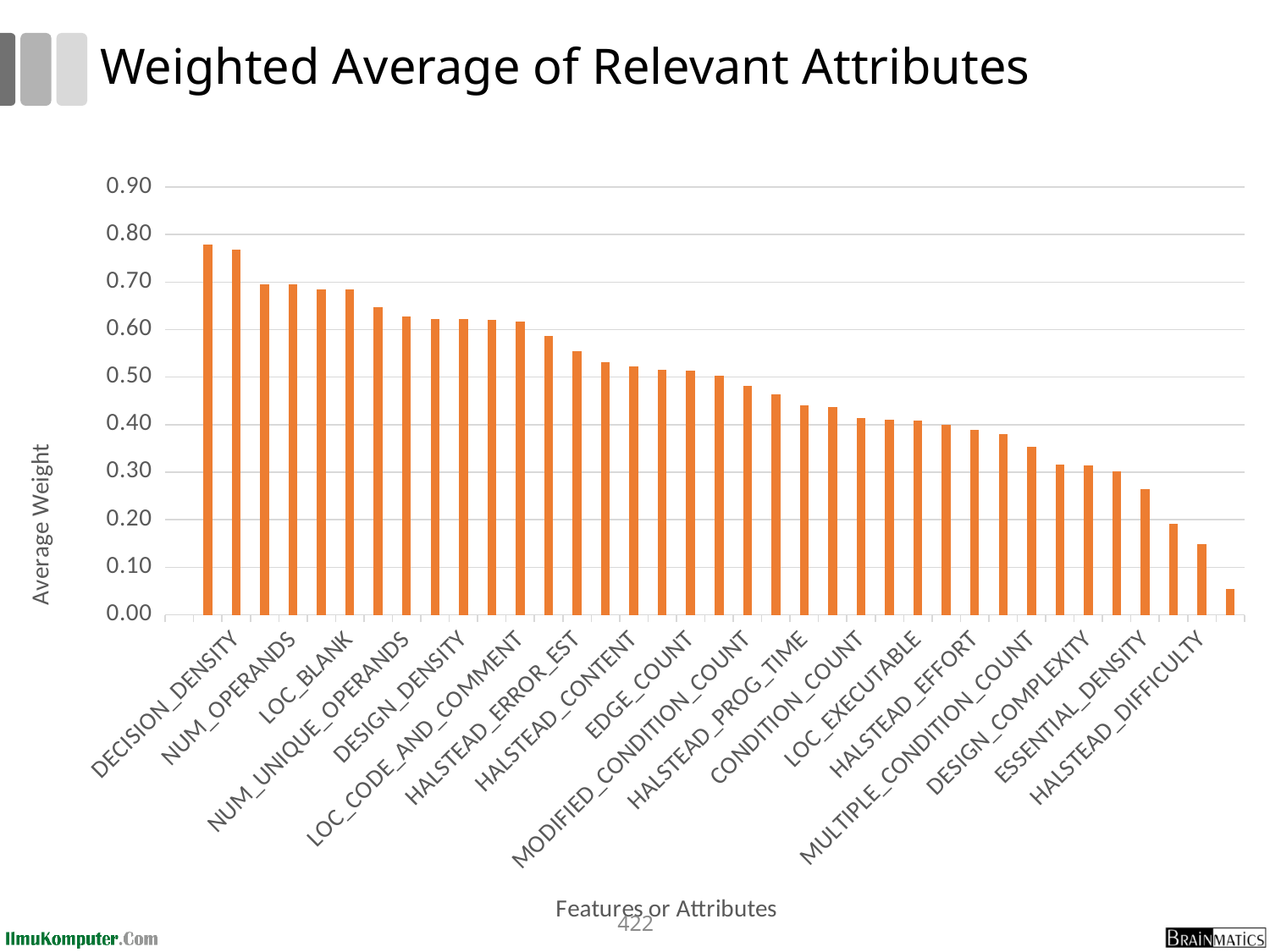
Is the value for HALSTEAD_EFFORT greater or less than 0.50? less What is the label of the vertical axis? Average Weight Is the value for DECISION_DENSITY greater or less than 0.70? greater Which has a larger average weight, DECISION_DENSITY or HALSTEAD_DIFFICULTY? DECISION_DENSITY What kind of chart is shown on the slide? bar chart Is the value for EDGE_COUNT greater or less than 0.60? less Which has a larger average weight, NUM_OPERANDS or CONDITION_COUNT? NUM_OPERANDS Do the bar values rise or fall from left to right along the x axis? fall What is the title of the chart? Weighted Average of Relevant Attributes